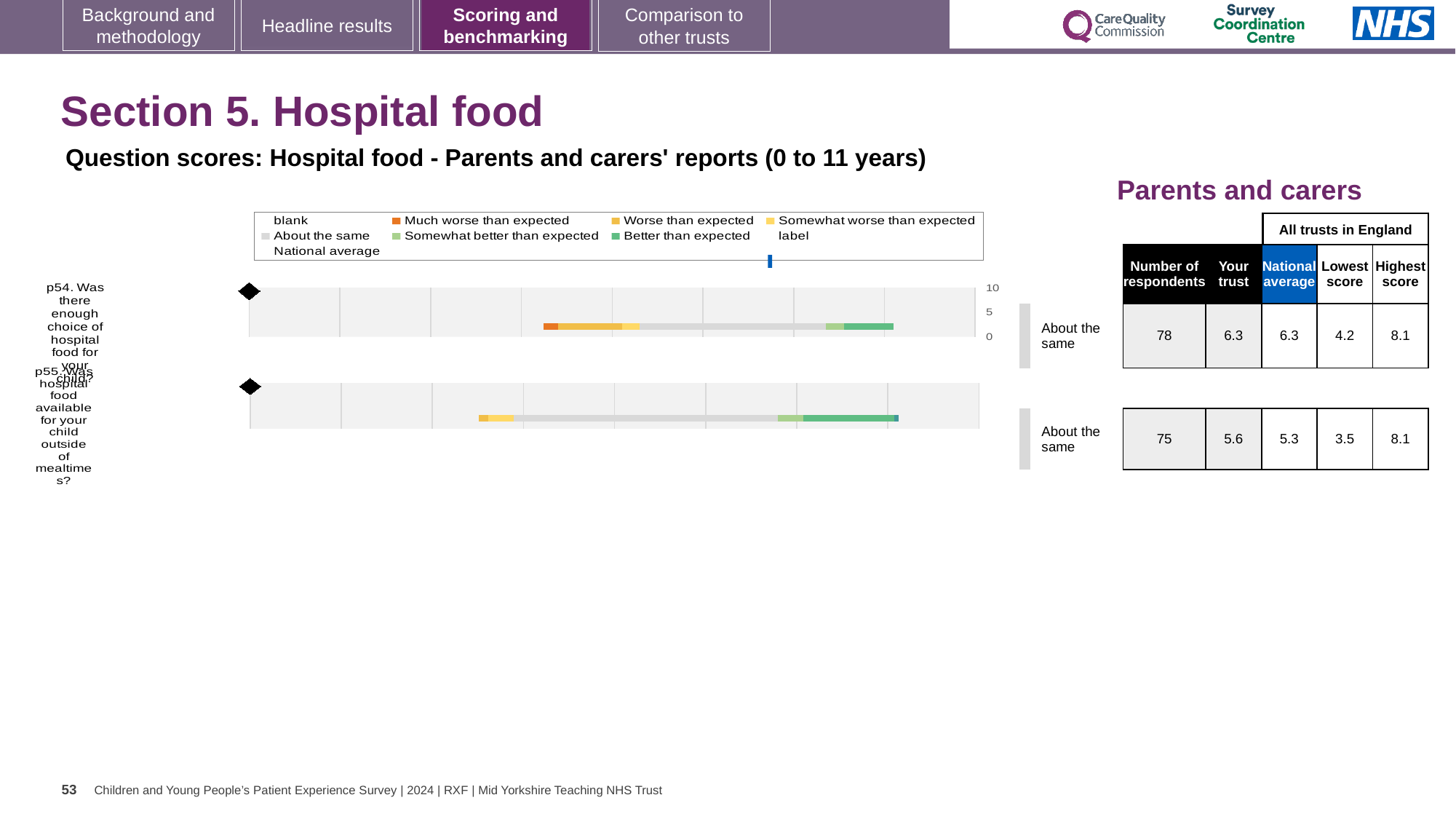
How many respondents answered p54? 78 What is the maximum value shown on the chart's score axis? 10 What is the 'Your trust' score for p54 (enough choice of hospital food for your child)? 6.3 What is the national average score for p55? 5.3 What is the highest score among all trusts in England for p54? 8.1 What kind of chart is used to show the question scores for p54 and p55? bar chart What is the 'Your trust' score for p55 (hospital food available outside of mealtimes)? 5.6 What benchmark category is shown next to the p54 bar? About the same What is the difference between the 'Your trust' score and the national average for p55? 0.3 What is the lowest score among all trusts in England for p55? 3.5 Which question has the higher 'Your trust' score, p54 or p55? p54 How many questions are plotted in the hospital food chart? 2